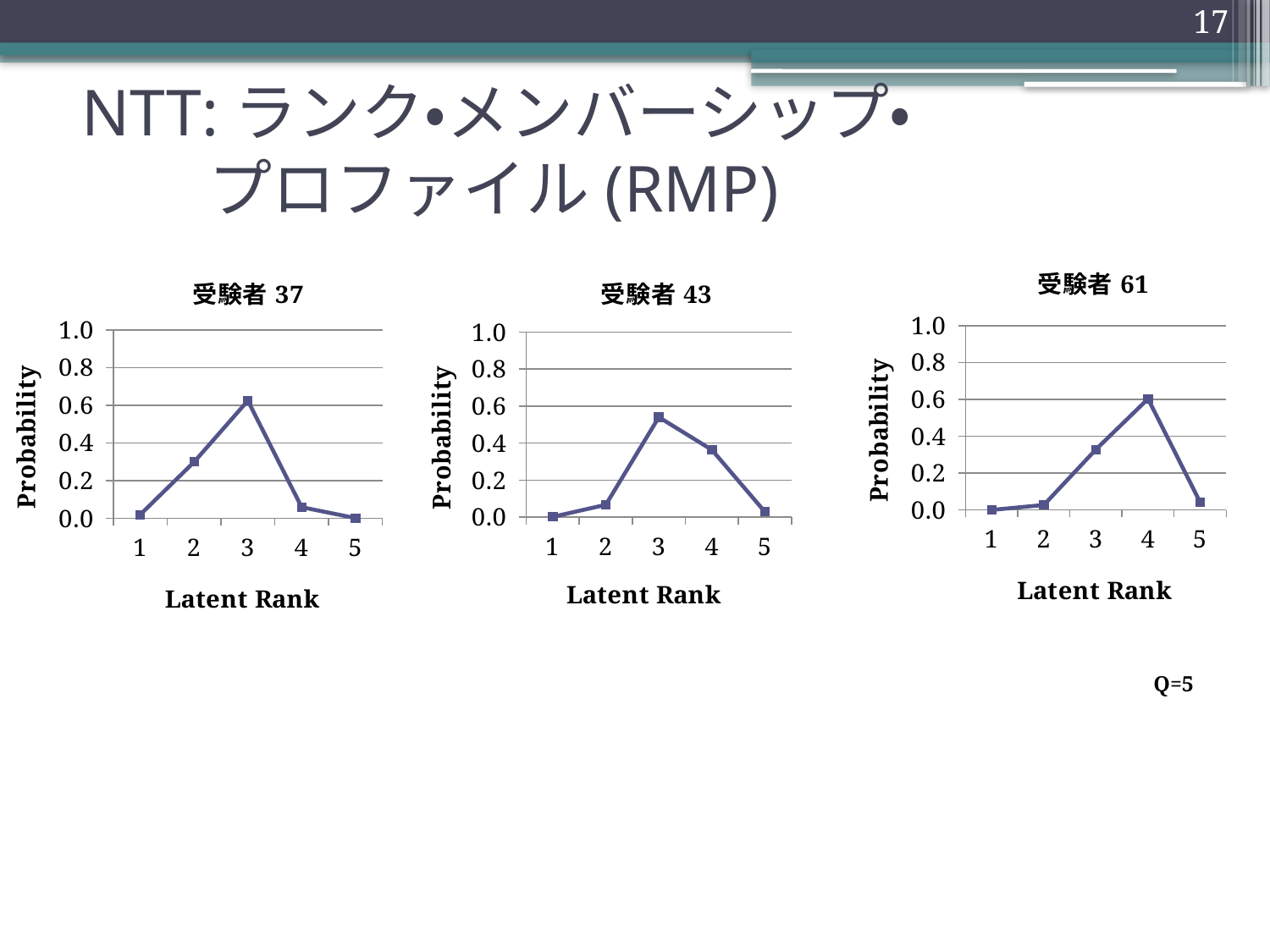
In the 受験者 37 chart, which has the higher probability, latent rank 2 or latent rank 4? latent rank 2 In the 受験者 61 chart, is the probability for latent rank 5 greater or less than 0.2? less In the 受験者 37 chart, is the probability for latent rank 3 greater or less than 0.4? greater What is the y-axis label on the 受験者 61 chart? Probability In the 受験者 61 chart, does the probability rise or fall from latent rank 1 to latent rank 4? rise What kind of chart is the 受験者 37 chart? line chart In the 受験者 37 chart, which latent rank has the highest probability? 3 In the 受験者 61 chart, which latent rank has the highest probability? 4 In the 受験者 43 chart, is the probability for latent rank 4 greater or less than 0.2? greater In the 受験者 43 chart, which has the higher probability, latent rank 3 or latent rank 4? latent rank 3 How many latent ranks are plotted on the x axis of the 受験者 43 chart? 5 In the 受験者 43 chart, which latent rank has the highest probability? 3